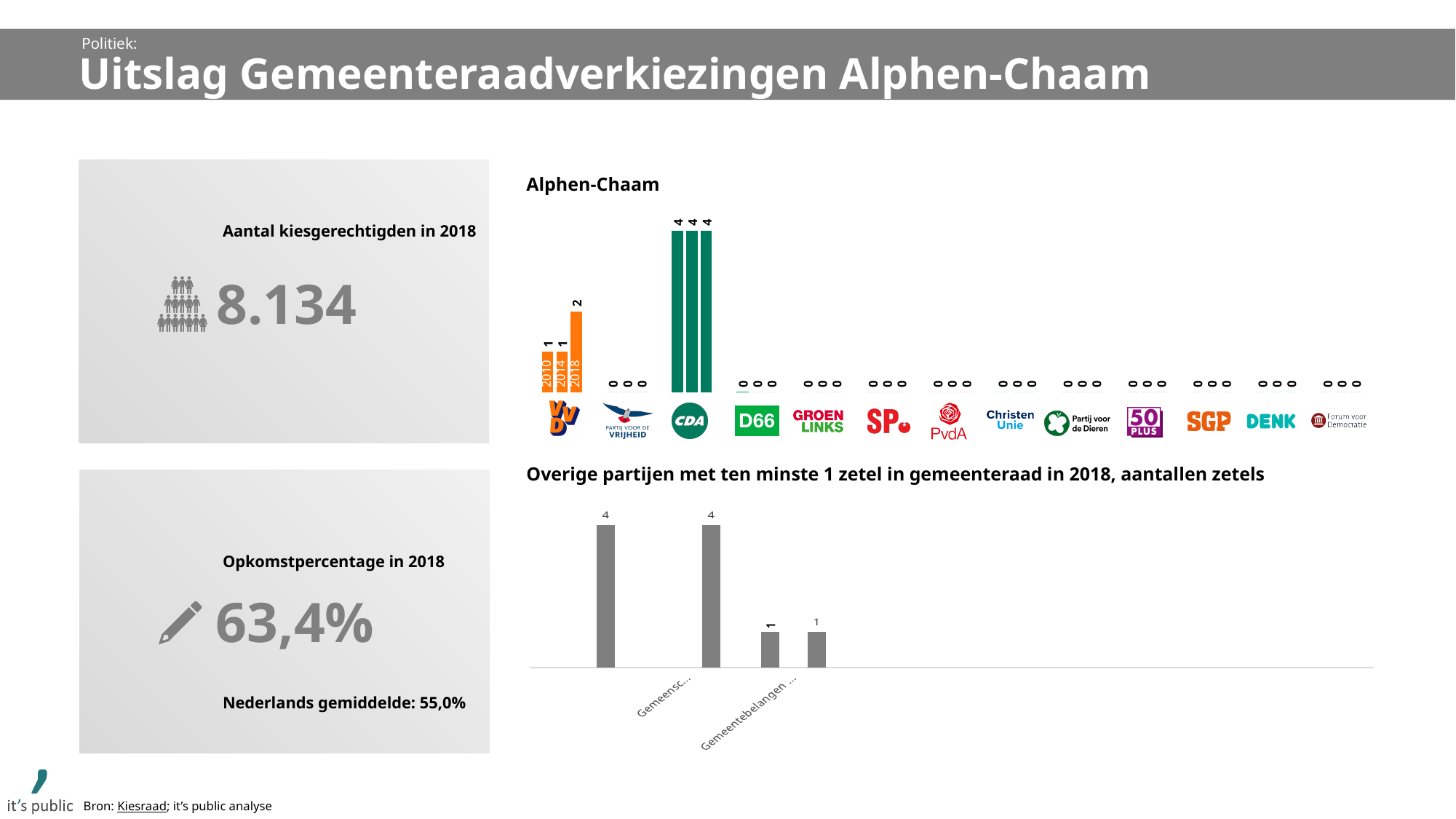
In the Alphen-Chaam chart, how many years are shown for each party? 3 In the Alphen-Chaam chart, how many seats did the VVD win in 2018? 2 In the Alphen-Chaam chart, how many seats did the CDA win in 2010? 4 In the chart titled 'Overige partijen met ten minste 1 zetel in gemeenteraad in 2018, aantallen zetels', what is the value of the last (rightmost) bar? 1 In the Alphen-Chaam chart, which party has the highest number of seats in 2018? CDA In the chart titled 'Overige partijen met ten minste 1 zetel in gemeenteraad in 2018, aantallen zetels', what is the value of the first (leftmost) bar? 4 What kind of chart is the Alphen-Chaam chart? bar chart In the Alphen-Chaam chart, do the VVD's seats rise or fall from 2010 to 2018? rise In the chart titled 'Overige partijen met ten minste 1 zetel in gemeenteraad in 2018, aantallen zetels', how many bars are plotted? 4 In the Alphen-Chaam chart, what is the difference between the CDA's and the VVD's seats in 2018? 2 In the Alphen-Chaam chart, how many seats did the VVD win in 2014? 1 In the Alphen-Chaam chart, did the VVD have more seats in 2014 or in 2018? 2018